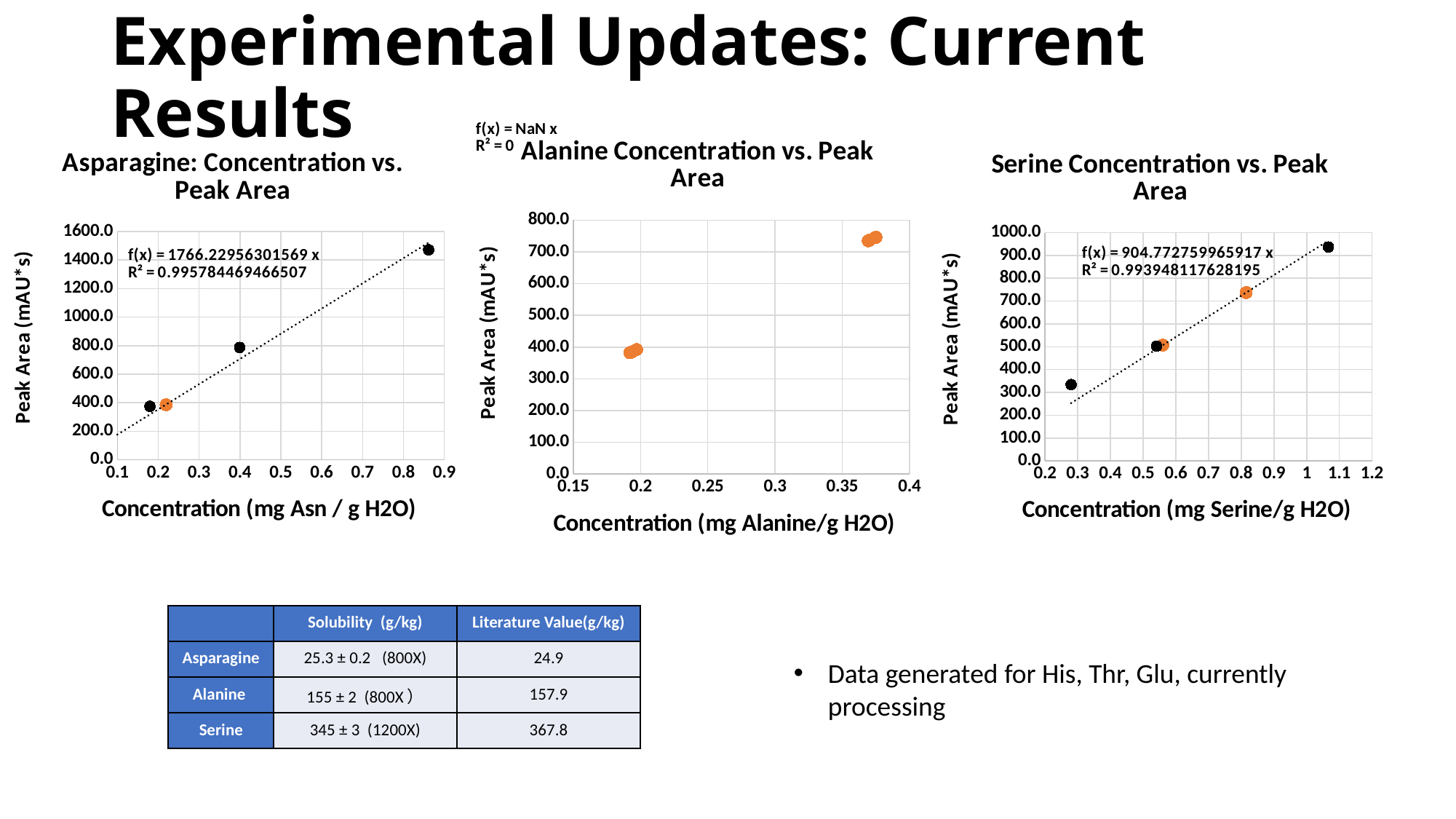
What is the x-axis label of the "Alanine Concentration vs. Peak Area" chart? Concentration (mg Alanine/g H2O) In the "Alanine Concentration vs. Peak Area" chart, is the peak area of the cluster near concentration 0.37 greater or less than 700.0? greater In the "Serine Concentration vs. Peak Area" chart, does peak area rise or fall as concentration increases? rise What is the R² value printed on the "Serine Concentration vs. Peak Area" chart? 0.993948117628195 In the "Serine Concentration vs. Peak Area" chart, is the peak area of the point at the lowest concentration greater or less than 400.0? less In the "Asparagine: Concentration vs. Peak Area" chart, is the peak area of the point at concentration 0.4 greater or less than 1000.0? less In the "Alanine Concentration vs. Peak Area" chart, does peak area rise or fall as concentration increases? rise What kind of chart is the "Asparagine: Concentration vs. Peak Area" chart? scatter chart In the "Asparagine: Concentration vs. Peak Area" chart, which point has the higher peak area: the one at concentration 0.4 or the one at concentration 0.86? the one at concentration 0.86 How many charts are shown on the slide? 3